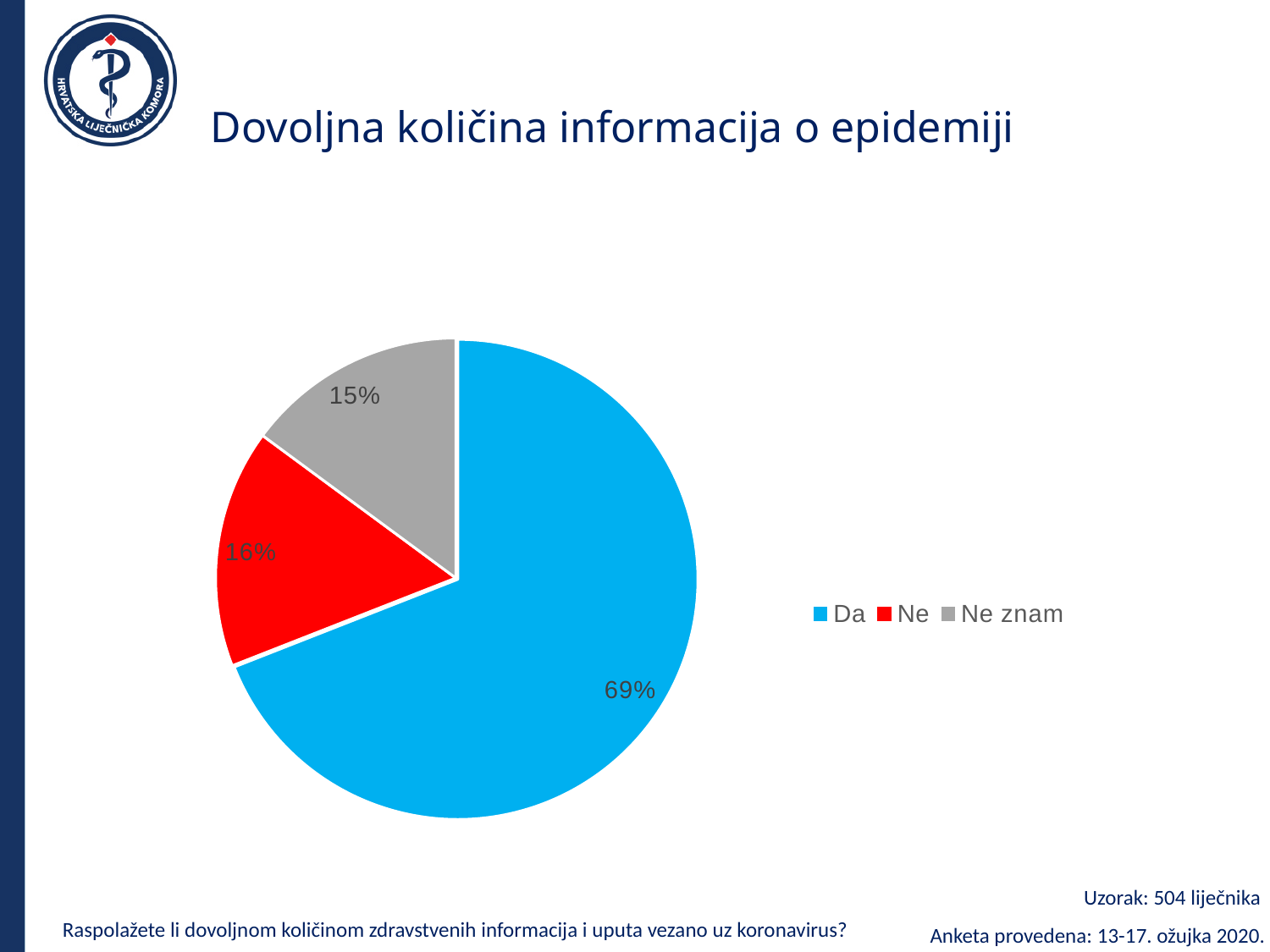
What percentage of respondents answered "Ne"? 16% What percentage of respondents answered "Da"? 69% What type of chart is shown on the slide? pie chart What percentage of respondents answered "Ne znam"? 15% What is the combined share of the "Ne" and "Ne znam" slices? 31% What colour is the "Ne" slice? red What is the difference in percentage points between the "Da" and "Ne" slices? 53 What is the title of the slide containing the chart? Dovoljna količina informacija o epidemiji How many entries does the legend list? 3 Which response has the largest share of the pie? Da How many slices does the pie chart have? 3 Which is larger, the "Da" slice or the "Ne znam" slice? Da